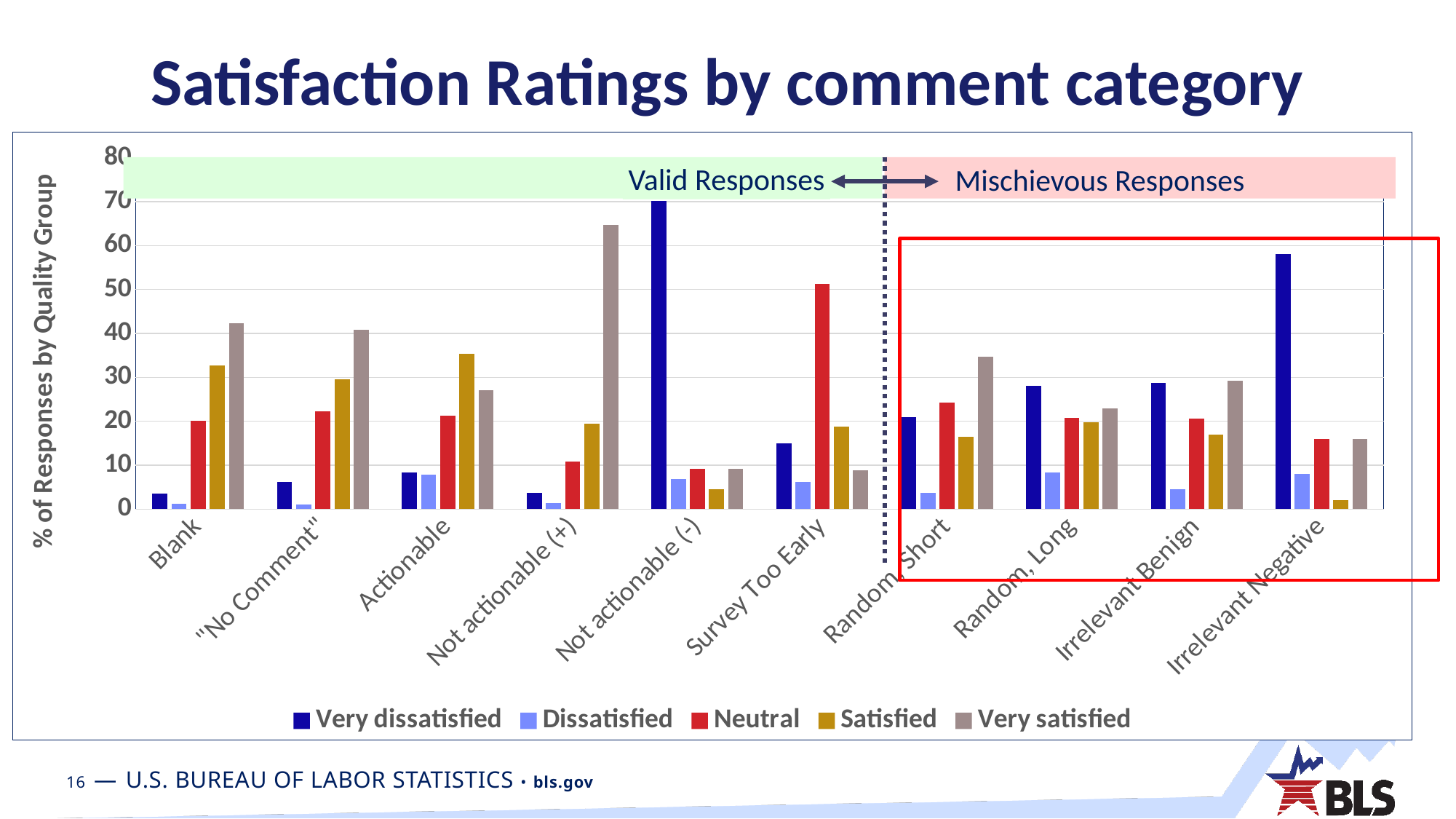
How many comment categories are shown on the x axis? 10 For the Blank category, which is larger: the Satisfied bar or the Neutral bar? Satisfied What kind of chart is shown on the slide? bar chart Is the Very dissatisfied value for Not actionable (-) greater or less than 60? greater Which comment category has the highest Very dissatisfied bar? Not actionable (-) Is the Neutral value for Survey Too Early greater or less than 40? greater Which comment category has the highest Very satisfied bar? Not actionable (+) How many series does the legend list? 5 Is the Very satisfied value for Irrelevant Negative greater or less than 20? less What is the title of the y axis? % of Responses by Quality Group Which has the larger Very dissatisfied value: Irrelevant Negative or Random, Short? Irrelevant Negative Which comment categories fall under the Mischievous Responses label? Random, Short; Random, Long; Irrelevant Benign; Irrelevant Negative